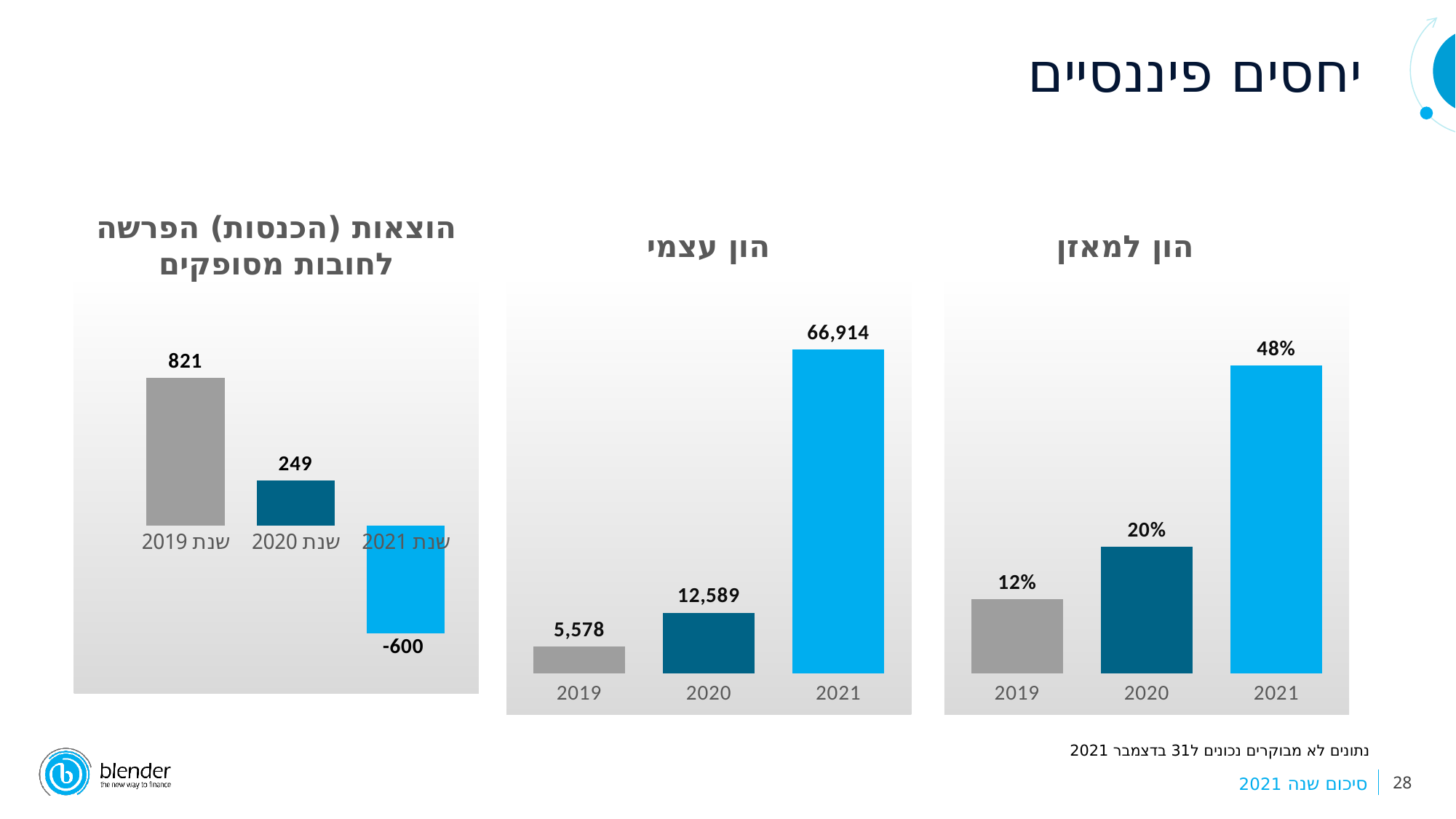
What type of chart is the middle chart (הון עצמי)? Bar chart In the middle chart (הון עצמי), what is the difference between the 2021 and 2020 values? 54,325 In the right chart (הון למאזן), what is the value for 2020? 20% In the right chart (הון למאזן), do the values rise or fall from 2019 to 2021? Rise In the left chart (הוצאות (הכנסות) הפרשה לחובות מסופקים), which is larger: the value for שנת 2019 or שנת 2020? שנת 2019 In the middle chart (הון עצמי), what is the value for 2021? 66,914 In the left chart (הוצאות (הכנסות) הפרשה לחובות מסופקים), what is the value for שנת 2021? -600 How many bars are in the right chart (הון למאזן)? 3 In the middle chart (הון עצמי), which year has the lowest value? 2019 In the left chart (הוצאות (הכנסות) הפרשה לחובות מסופקים), which year has the highest value? שנת 2019 What is the title of the right chart? הון למאזן In the right chart (הון למאזן), what is the difference between the 2021 and 2019 values? 36%